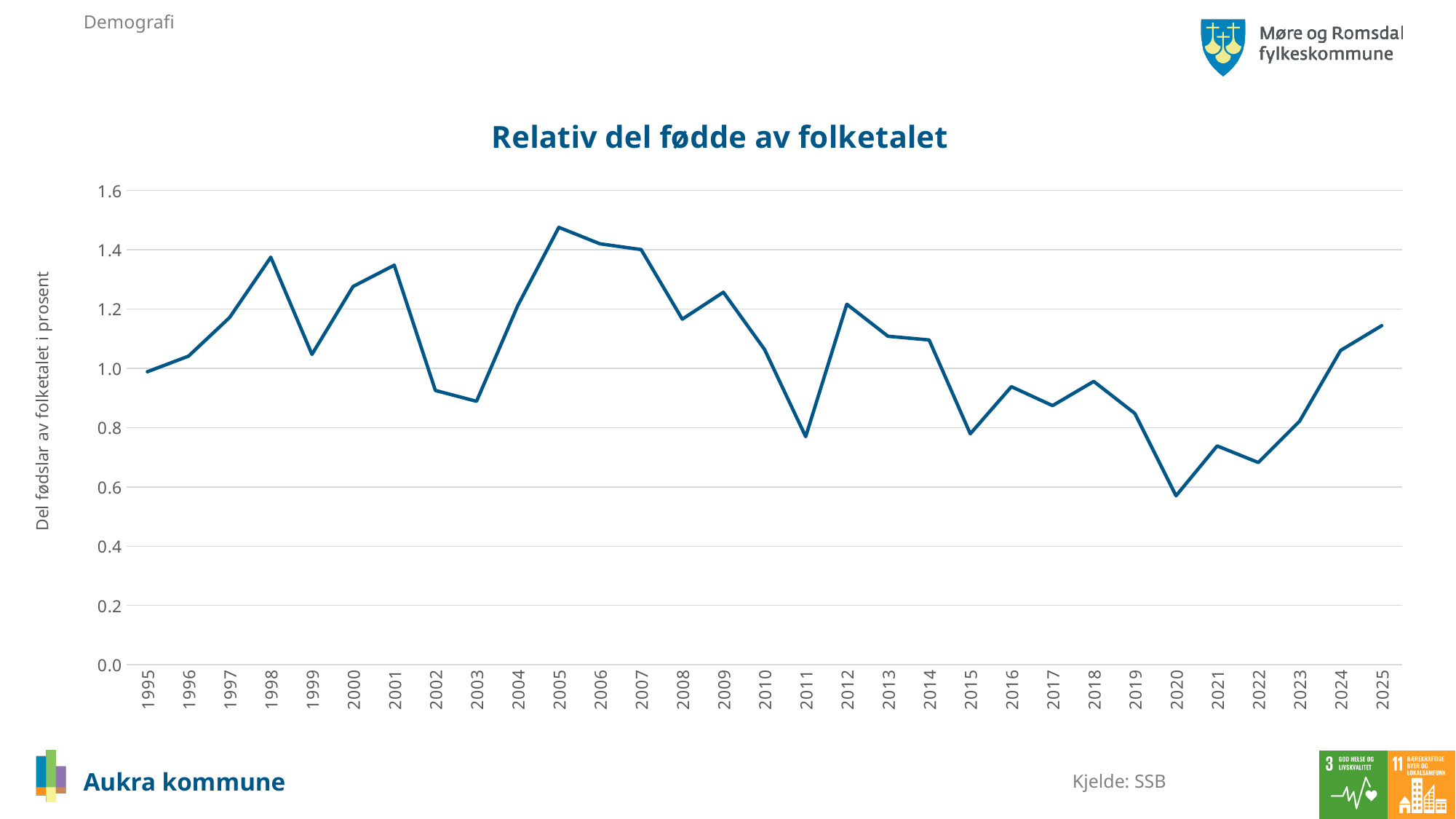
Does the line rise or fall from 2020 to 2025? rise Is the value for 2015 greater or less than 1.0? less What kind of chart is shown on the slide? line chart Is the value for 1998 greater or less than 1.2? greater In which year does the line reach its highest value? 2005 Is the value for 2005 greater or less than 1.4? greater What is the title of the chart? Relativ del fødde av folketalet In which year does the line reach its lowest value? 2020 How many years are plotted along the x axis of the chart? 31 Which year has the larger value, 1998 or 1999? 1998 What is the label on the vertical axis of the chart? Del fødslar av folketalet i prosent